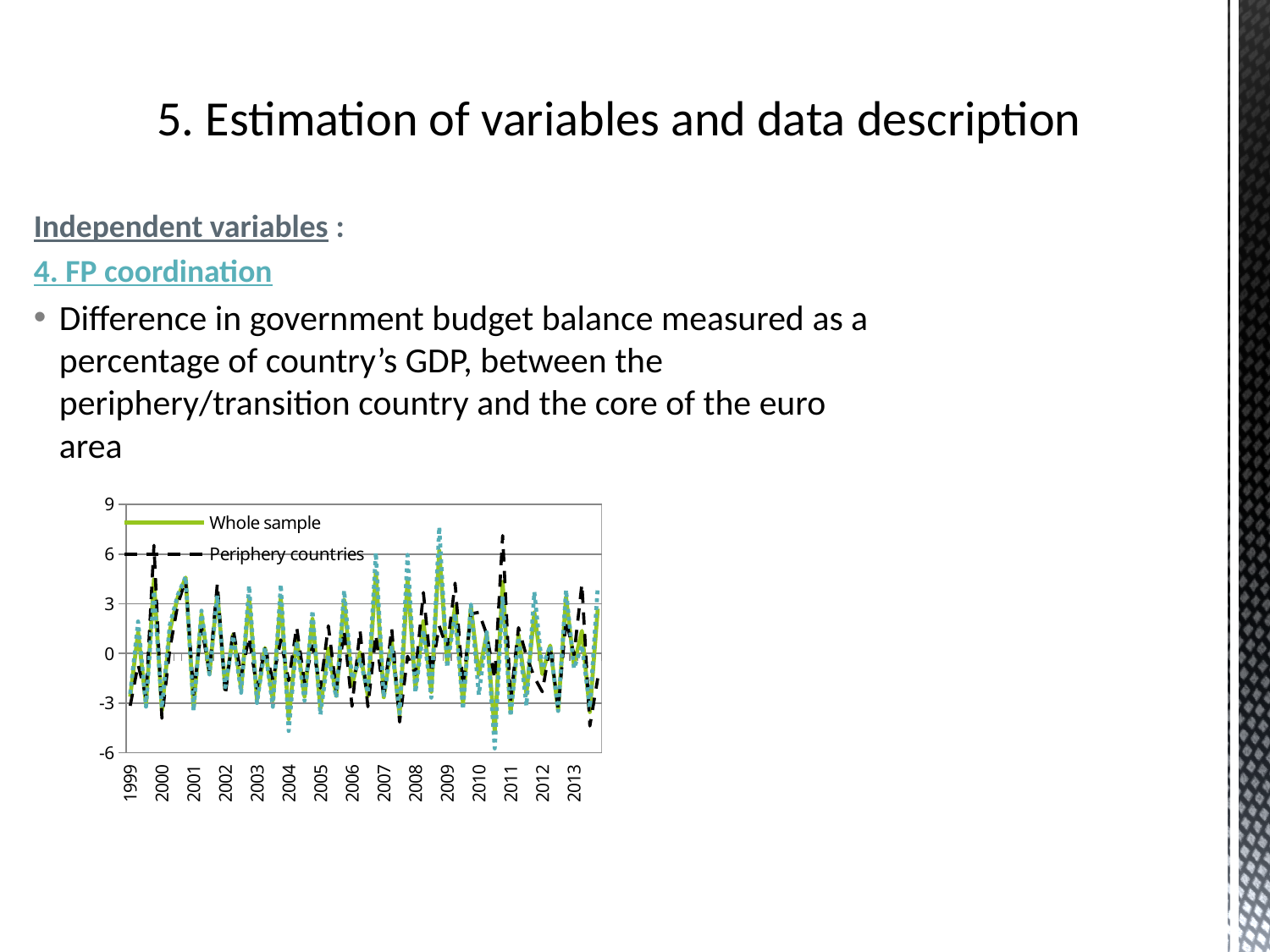
How many series does the chart's legend list? 2 What is the last year labelled on the x axis of the chart? 2013 What is the highest value shown on the y axis of the chart? 9 What is the lowest value shown on the y axis of the chart? -6 What is the second series named in the chart's legend? Periphery countries What is the first series named in the chart's legend? Whole sample How many year labels are shown along the x axis of the chart? 15 What is the first year labelled on the x axis of the chart? 1999 What kind of chart is shown on the slide? line chart